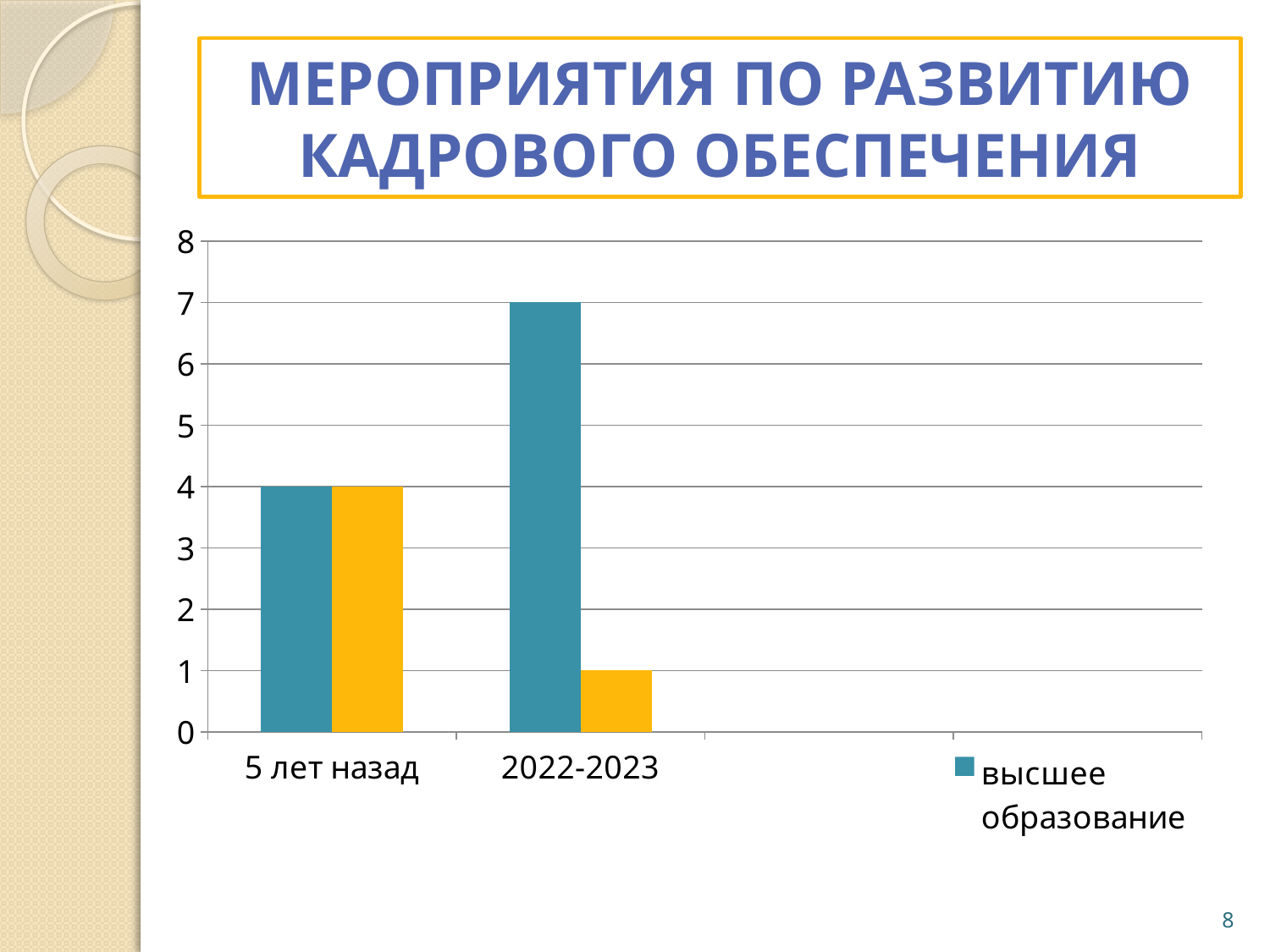
By how much does the value for высшее образование in 2022-2023 exceed the value for 5 лет назад? 3 Is the value for высшее образование in 2022-2023 greater or less than 5? greater In 2022-2023, which is larger: the высшее образование bar or the orange bar? высшее образование What is the value for высшее образование for 5 лет назад? 4 Does the value for высшее образование rise or fall from 5 лет назад to 2022-2023? rises What kind of chart is shown on the slide? bar chart What is the value of the orange bar for 2022-2023? 1 What is the value for высшее образование in 2022-2023? 7 In which category is the value for высшее образование highest? 2022-2023 What entry does the legend list? высшее образование How many categories are shown on the x axis? 2 What is the value of the orange bar for 5 лет назад? 4